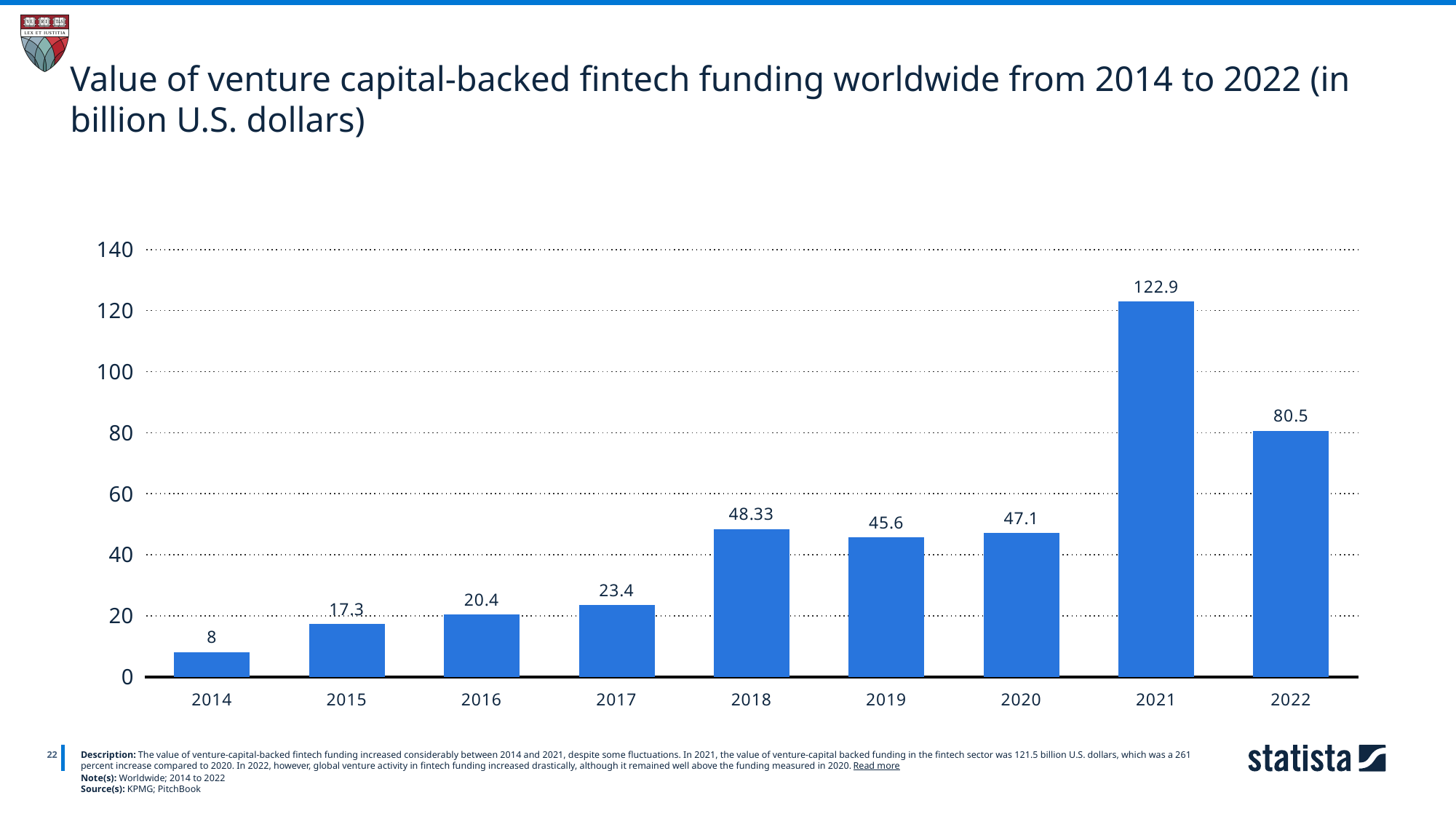
Is the value for 2022 greater or less than 100? less What is the value of venture capital-backed fintech funding for 2021? 122.9 Which is larger, the value for 2017 or the value for 2016? 2017 What kind of chart is shown on the slide? bar chart What is the value shown for 2014? 8 How many years are shown on the x axis? 9 What is the value shown for 2018? 48.33 What is the difference between the values for 2020 and 2019? 1.5 Do the values rise or fall from 2014 to 2018? rise Which year has the lowest value? 2014 Which year has the highest value? 2021 What is the difference between the values for 2021 and 2022? 42.4